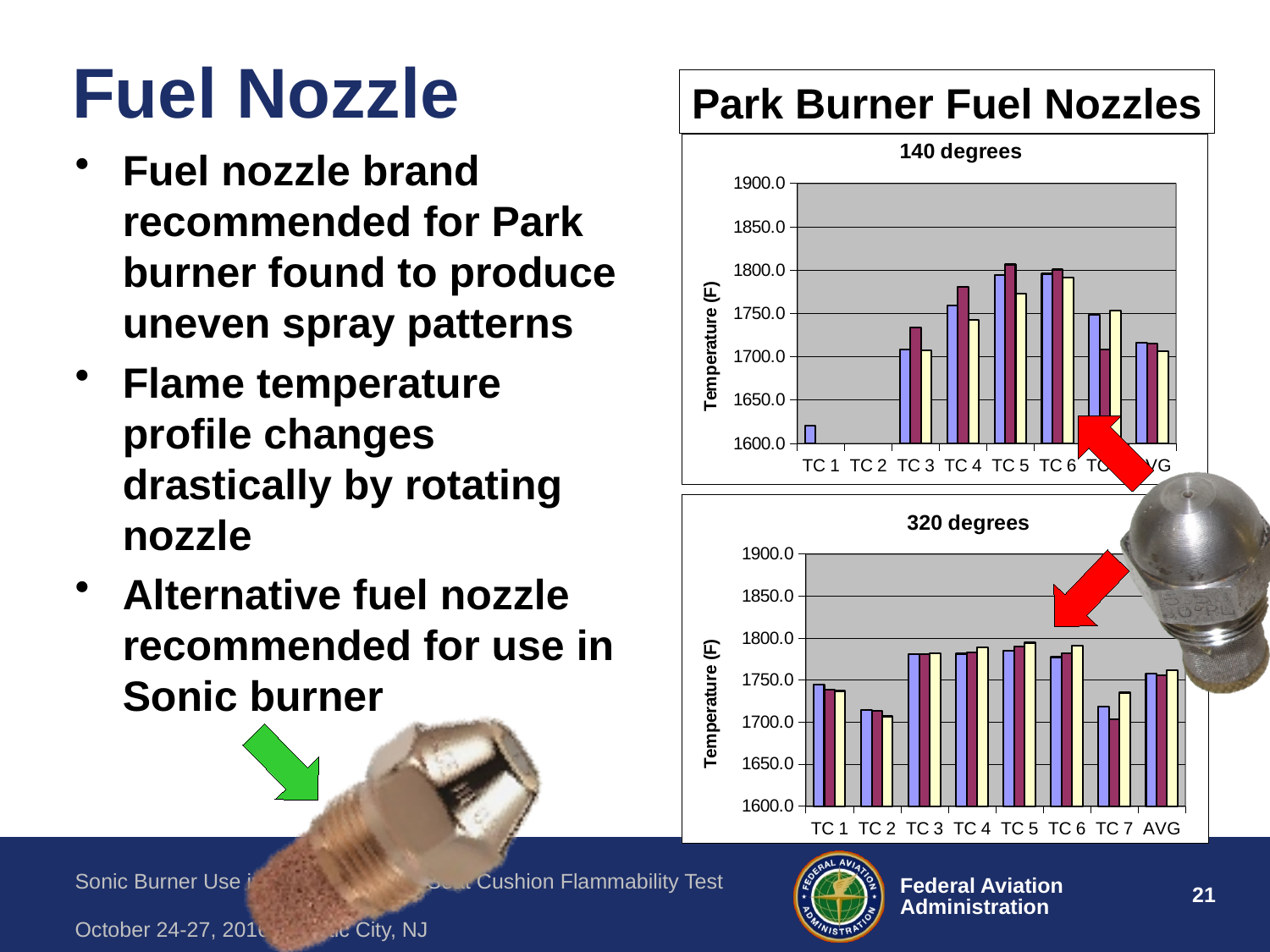
In the '320 degrees' chart, are the values for TC 2 greater or less than 1750? less In the '140 degrees' chart, are the values for TC 5 greater or less than 1750? greater In the '140 degrees' chart, which is larger, the value for TC 5 or the value for TC 1? TC 5 In the '320 degrees' chart, which is larger, the value for TC 3 or the value for TC 2? TC 3 In the '320 degrees' chart, are the values for TC 5 greater or less than 1750? greater What kind of chart is the '140 degrees' chart? bar chart How many categories are shown on the x axis of the '320 degrees' chart? 8 What is the y-axis label on the '320 degrees' chart? Temperature (F) In the '140 degrees' chart, which category has the tallest bars? TC 5 What is the overall title above the two charts on the slide? Park Burner Fuel Nozzles